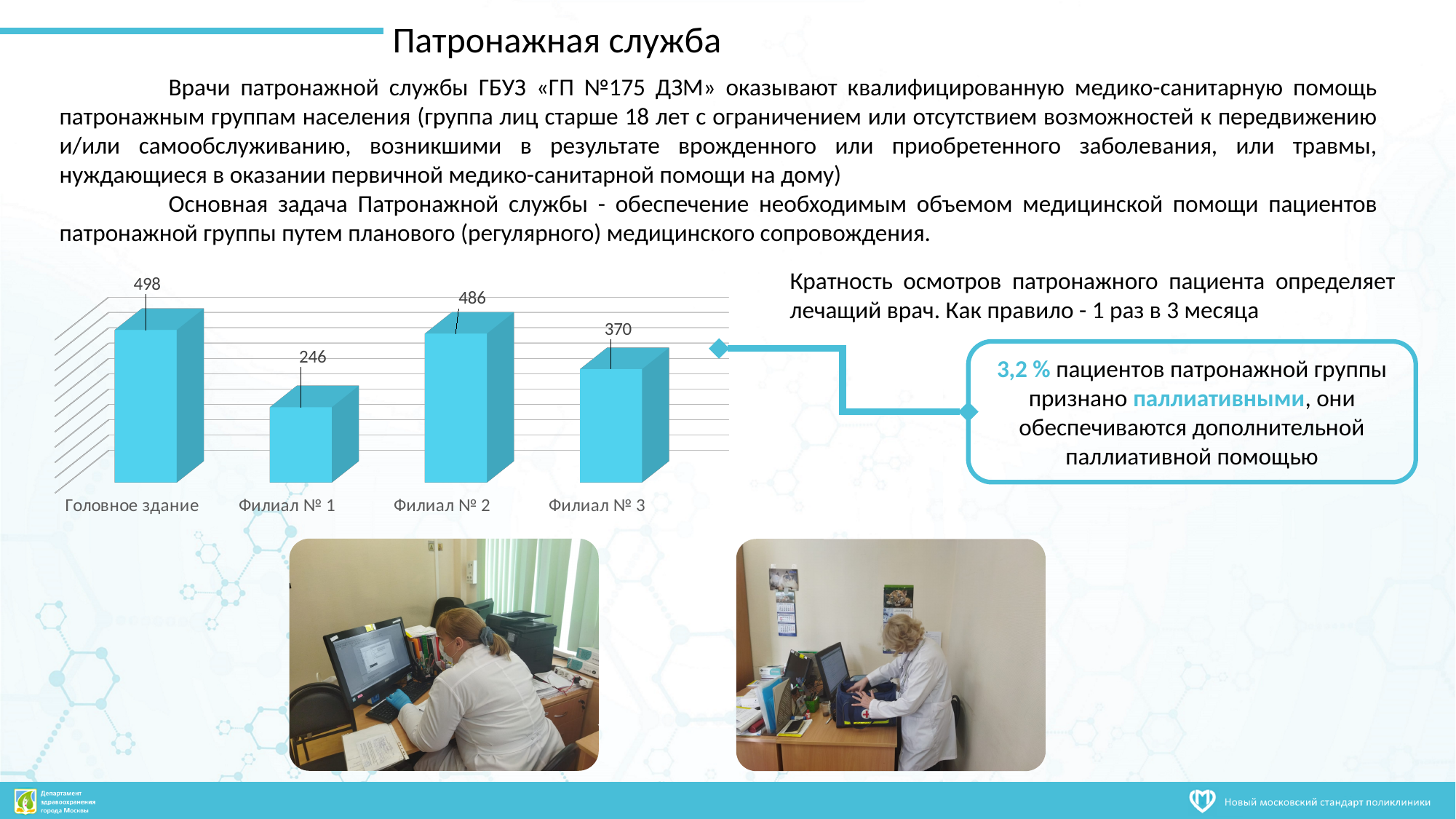
How many categories are shown in the chart? 4 What is the value for Головное здание? 498 Which is larger, the value for Филиал № 3 or the value for Филиал № 1? Филиал № 3 What is the value for Филиал № 3? 370 Which category has the highest value? Головное здание What is the difference between the values for Филиал № 2 and Филиал № 3? 116 What is the value for Филиал № 2? 486 What kind of chart is shown on the slide? Bar chart Which category has the lowest value? Филиал № 1 What is the value for Филиал № 1? 246 What is the difference between the values for Головное здание and Филиал № 1? 252 What is the total of the values for all four categories in the chart? 1600